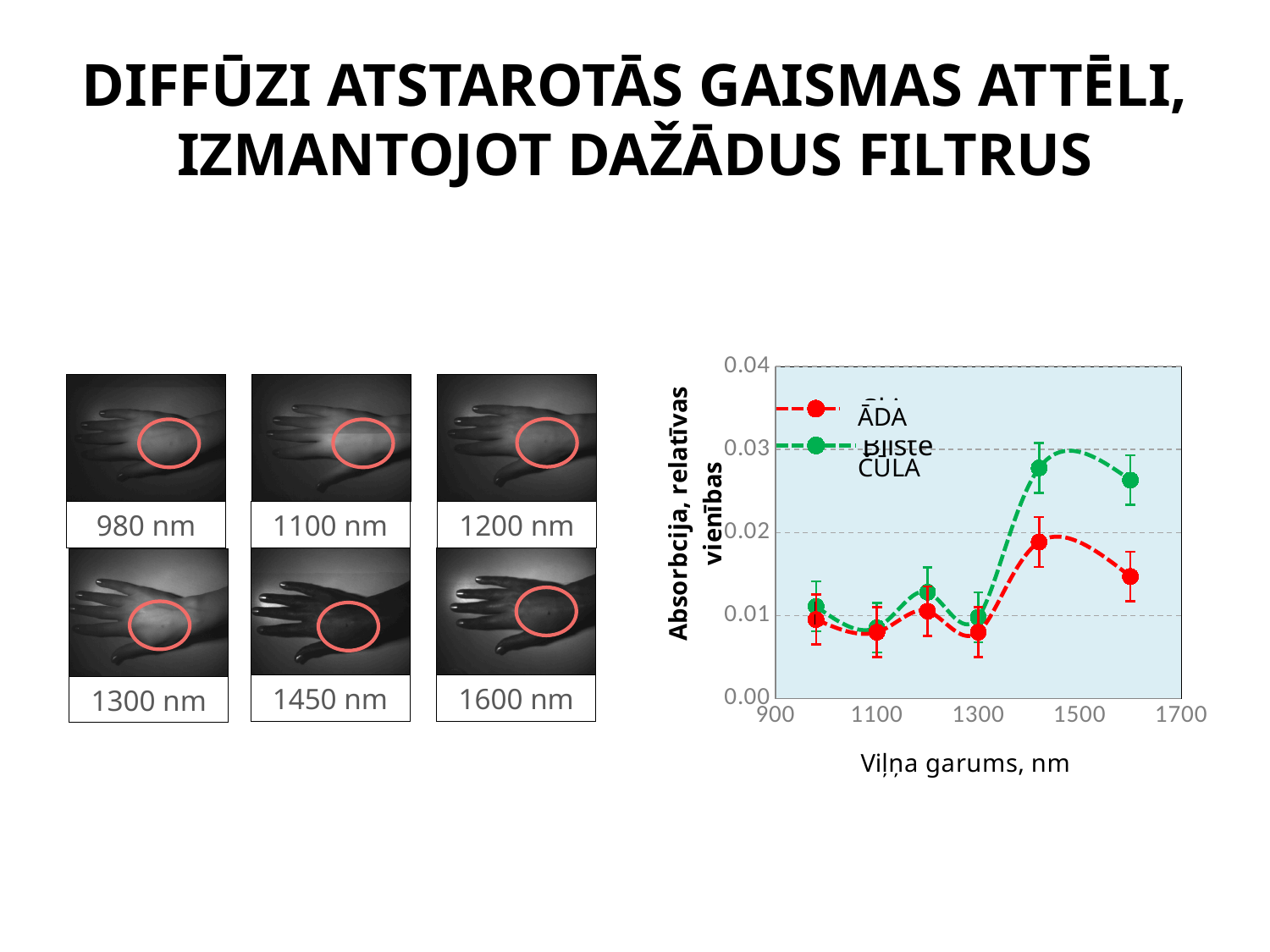
Is the value for ČŪLA at 1600 nm greater or less than 0.02? greater How many data points are plotted for the ĀDA series? 6 Is the value for ĀDA at 1600 nm greater or less than 0.01? greater Is the value for ČŪLA at 1450 nm greater or less than 0.02? greater Between 1300 nm and 1450 nm, do the values of both series rise or fall? rise At 1600 nm, which series has the higher absorption, ĀDA or ČŪLA? ČŪLA At 1450 nm, which series has the higher absorption, ĀDA or ČŪLA? ČŪLA At which wavelength does the ĀDA series reach its highest value? 1450 nm What kind of chart is shown on the slide? line chart What is the label of the x axis of the chart? Viļņa garums, nm How many series does the chart legend list? 2